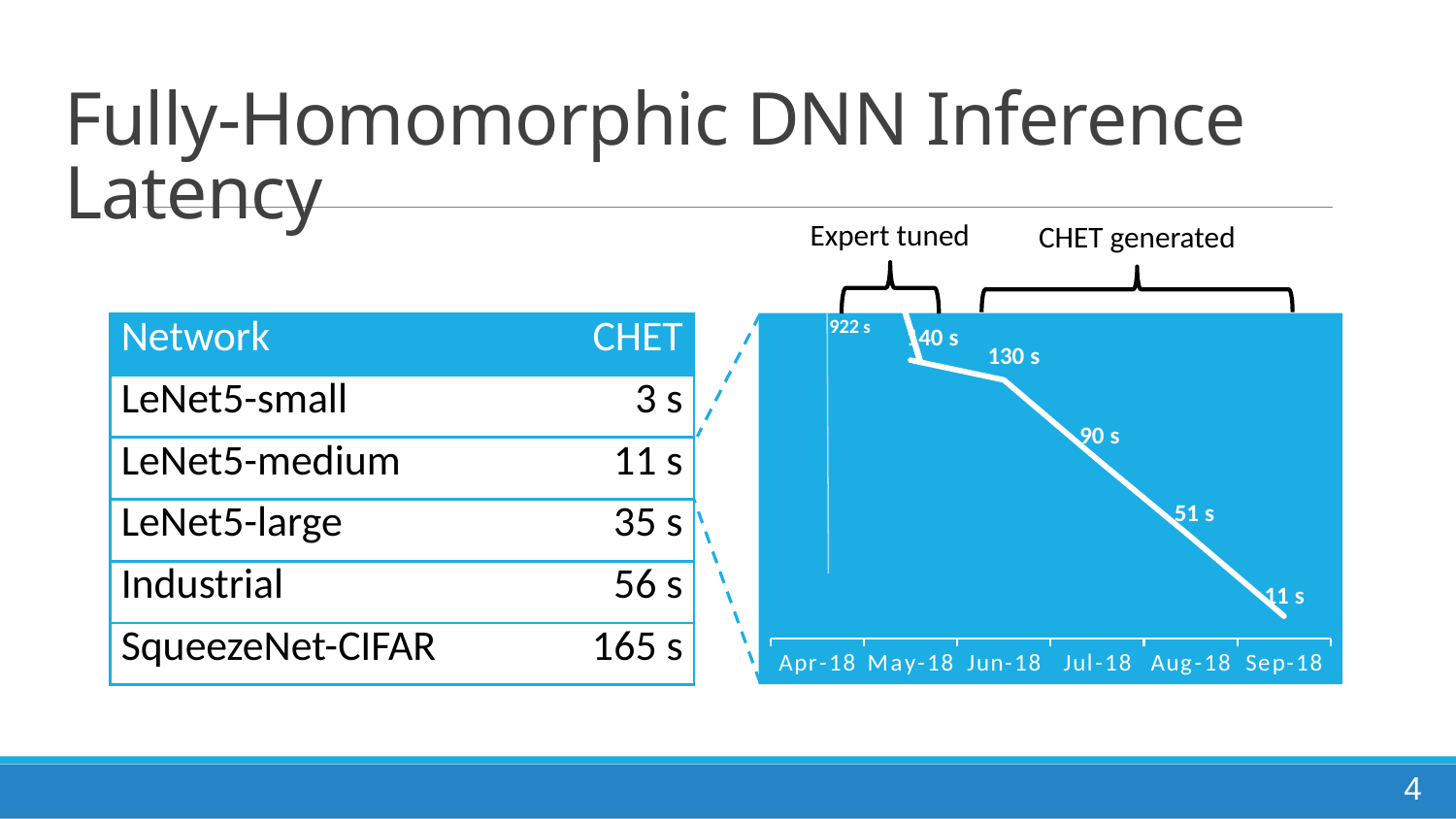
What is the latency value labelled at Jun-18 on the line chart? 130 s What is the difference between the Jun-18 and Jul-18 values on the line chart? 40 s What is the difference between the Aug-18 and Sep-18 values on the line chart? 40 s What kind of chart is shown on the right of the slide? line chart Do the values on the line chart rise or fall from Apr-18 to Sep-18? fall What is the latency value labelled at Jul-18 on the line chart? 90 s What is the latency value labelled at Apr-18 on the line chart? 922 s Which month has the lowest latency on the line chart? Sep-18 What is the latency value labelled at Sep-18 on the line chart? 11 s Which month has the highest latency on the line chart? Apr-18 How many months are shown on the x axis of the line chart? 6 Which is larger on the line chart, the value for Jul-18 or the value for Aug-18? Jul-18